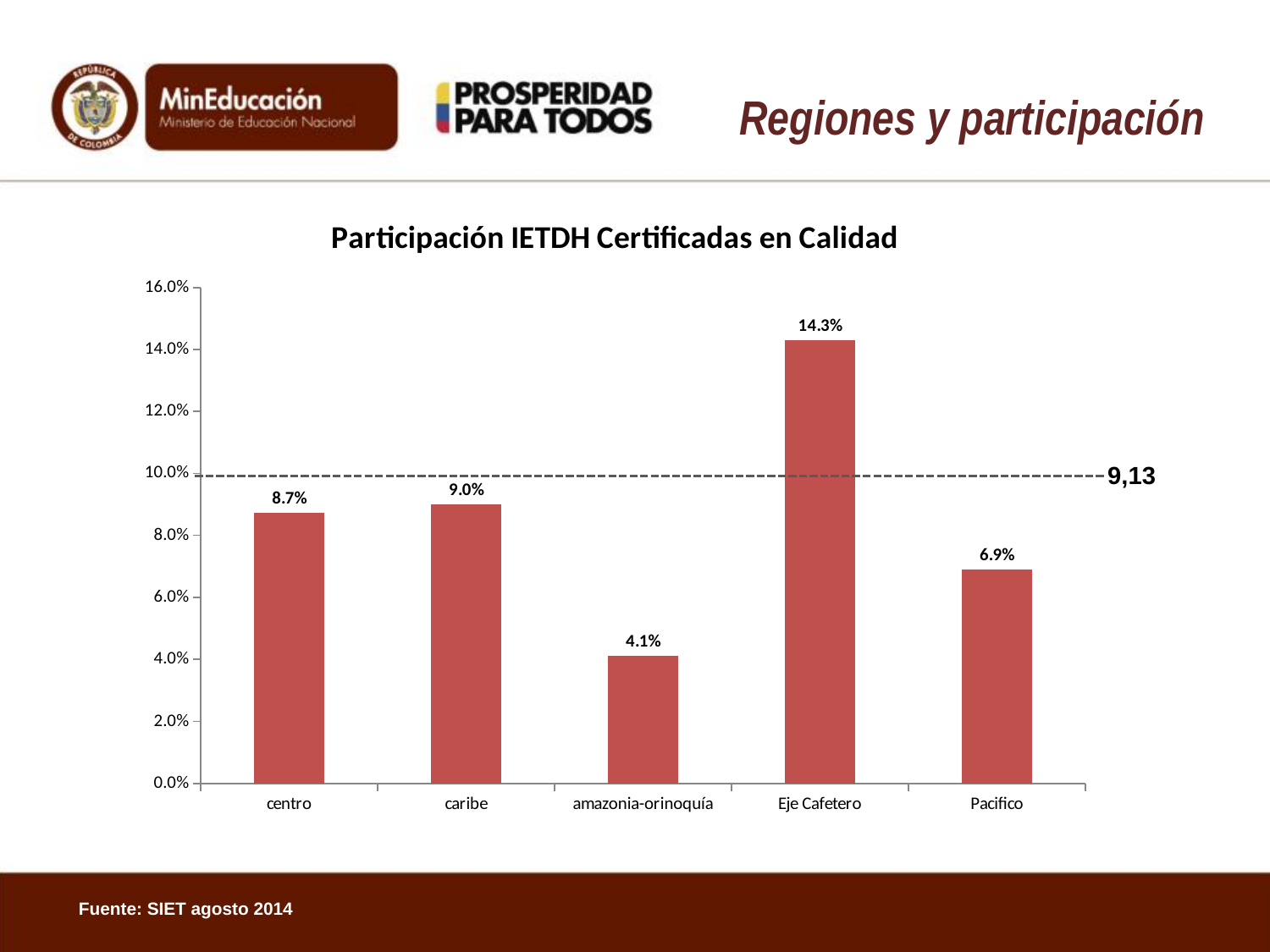
Which region has the lowest participation? amazonia-orinoquía What is the value for Pacifico? 6.9% How many regions are shown on the x axis? 5 Is the value for Eje Cafetero greater or less than 12.0%? greater Which is larger, the value for centro or the value for Pacifico? centro What kind of chart is this? bar chart Which region has the highest participation? Eje Cafetero What is the difference between the values for Eje Cafetero and Pacifico? 7.4% What is the value for amazonia-orinoquía? 4.1% What is the value for Eje Cafetero? 14.3% What is the difference between the values for caribe and centro? 0.3% What is the title of the chart? Participación IETDH Certificadas en Calidad